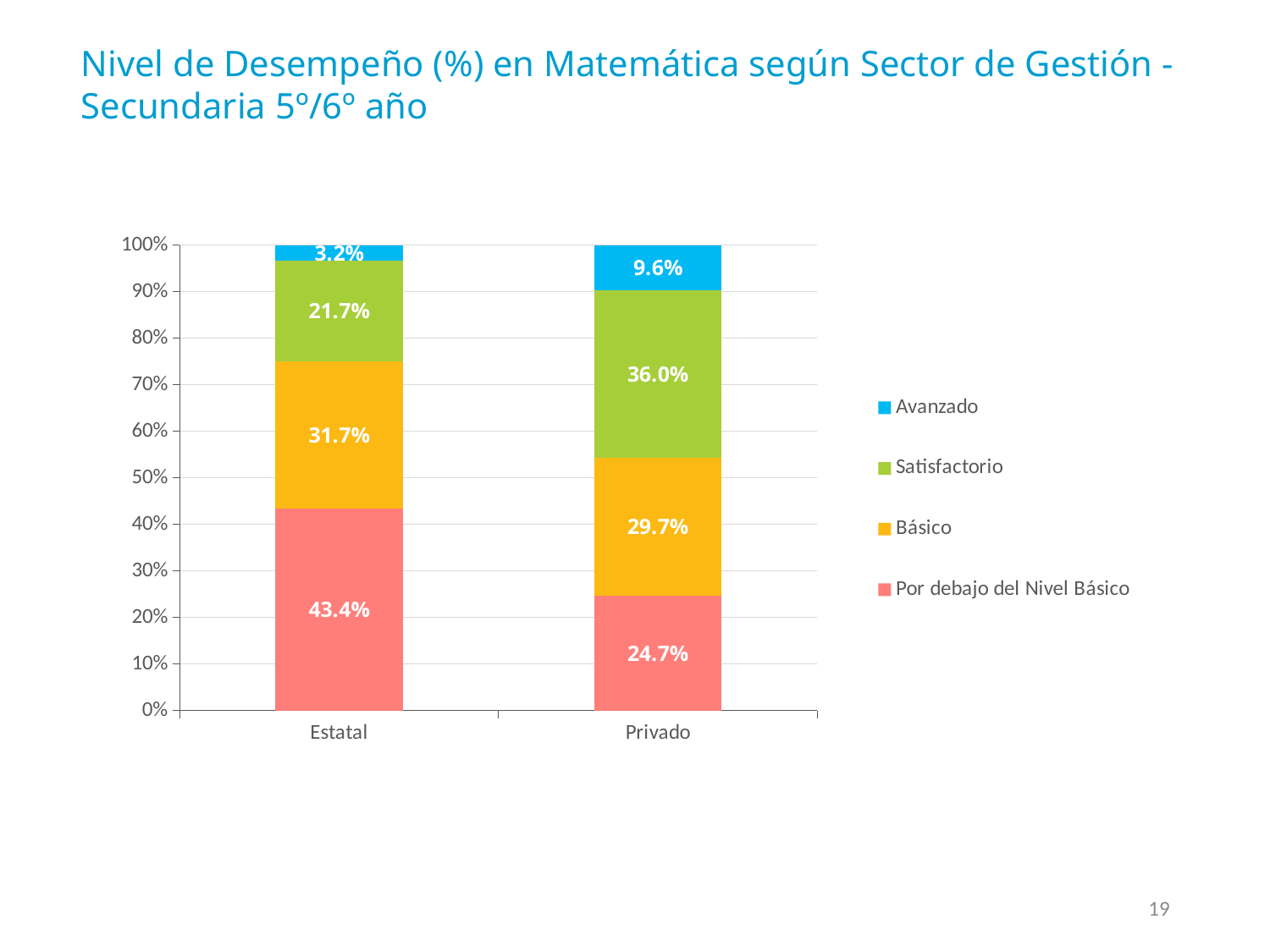
What is the value for Avanzado in the Privado bar? 9.6% How many series does the legend list? 4 What is the value for Por debajo del Nivel Básico in the Estatal bar? 43.4% Which sector has the higher value for Por debajo del Nivel Básico? Estatal Which sector has the higher value for Avanzado? Privado What kind of chart is shown on the slide? Stacked bar chart What is the difference between the Por debajo del Nivel Básico values for Estatal and Privado? 18.7% What is the value for Satisfactorio in the Privado bar? 36.0% What is the difference between the Satisfactorio values for Privado and Estatal? 14.3% What is the value for Básico in the Estatal bar? 31.7% Which series has the lowest value in the Estatal bar? Avanzado How many categories are shown on the x axis? 2